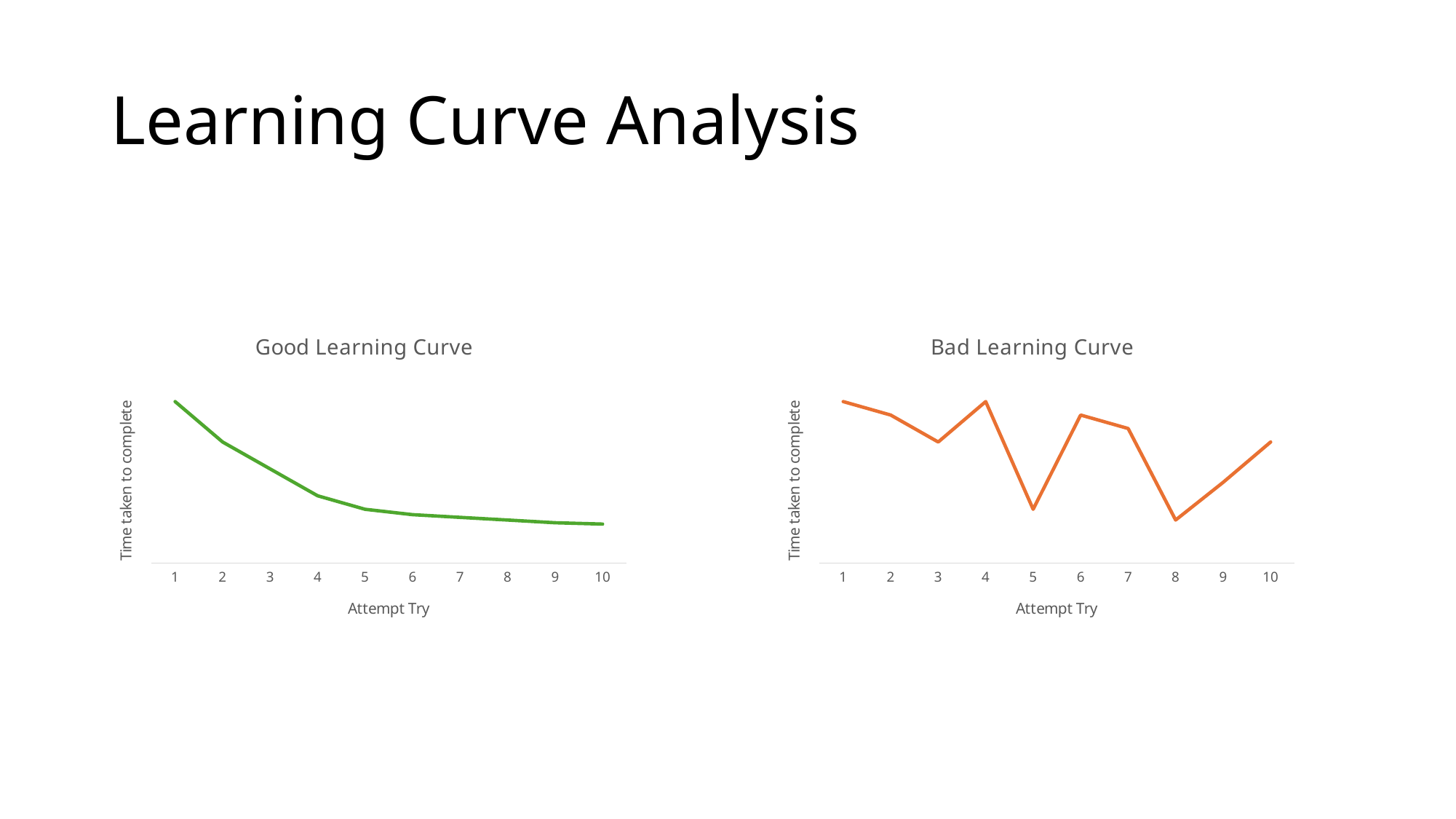
What is the x-axis label on the Good Learning Curve chart? Attempt Try What kind of chart is the Good Learning Curve chart? line chart In the Bad Learning Curve chart, is the time taken to complete larger at attempt 5 or attempt 6? attempt 6 In the Bad Learning Curve chart, does the time taken to complete fall steadily or fluctuate up and down across the attempts? fluctuate up and down In the Good Learning Curve chart, is the time taken to complete larger at attempt 1 or attempt 5? attempt 1 In the Good Learning Curve chart, does the time taken to complete rise or fall as the attempt number increases? fall What kind of chart is the Bad Learning Curve chart? line chart What colour is the line in the Bad Learning Curve chart? orange In the Good Learning Curve chart, which attempt has the highest time taken to complete? 1 In the Bad Learning Curve chart, is the time taken to complete larger at attempt 8 or attempt 10? attempt 10 In the Good Learning Curve chart, how many attempts are plotted along the x axis? 10 In the Bad Learning Curve chart, how many attempts are plotted along the x axis? 10